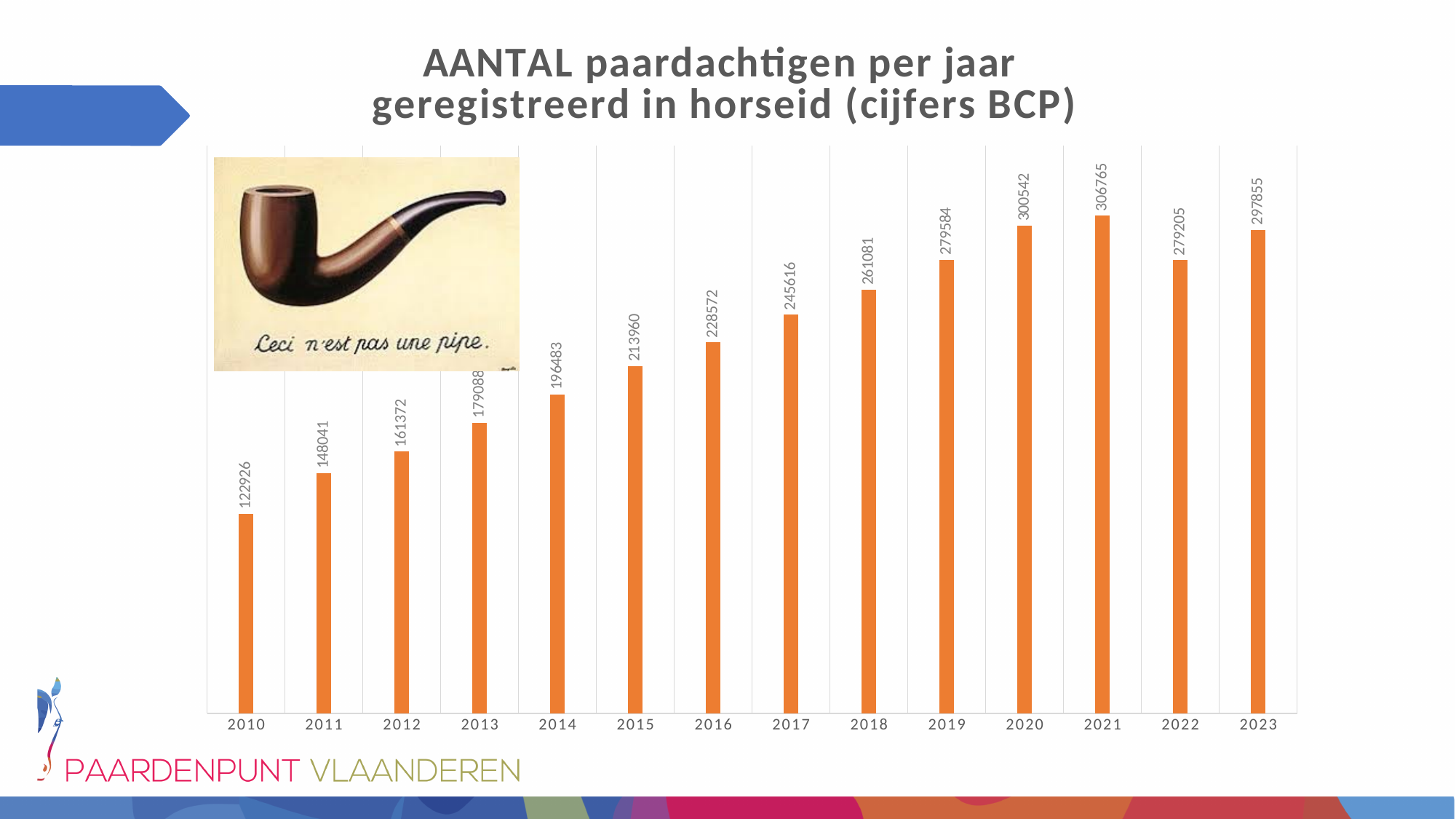
What type of chart is shown on the slide? bar chart Do the values generally rise or fall from 2010 to 2021? rise Which is larger, the value for 2019 or the value for 2022? 2019 Which year has the highest value? 2021 What is the difference between the values for 2011 and 2010? 25115 Which year has the lowest value? 2010 What is the value for 2016? 228572 What is the title of the chart? AANTAL paardachtigen per jaar geregistreerd in horseid (cijfers BCP) How many years are shown on the x axis of the chart? 14 What is the value for 2023? 297855 What is the difference between the values for 2021 and 2022? 27560 What is the value for 2010? 122926